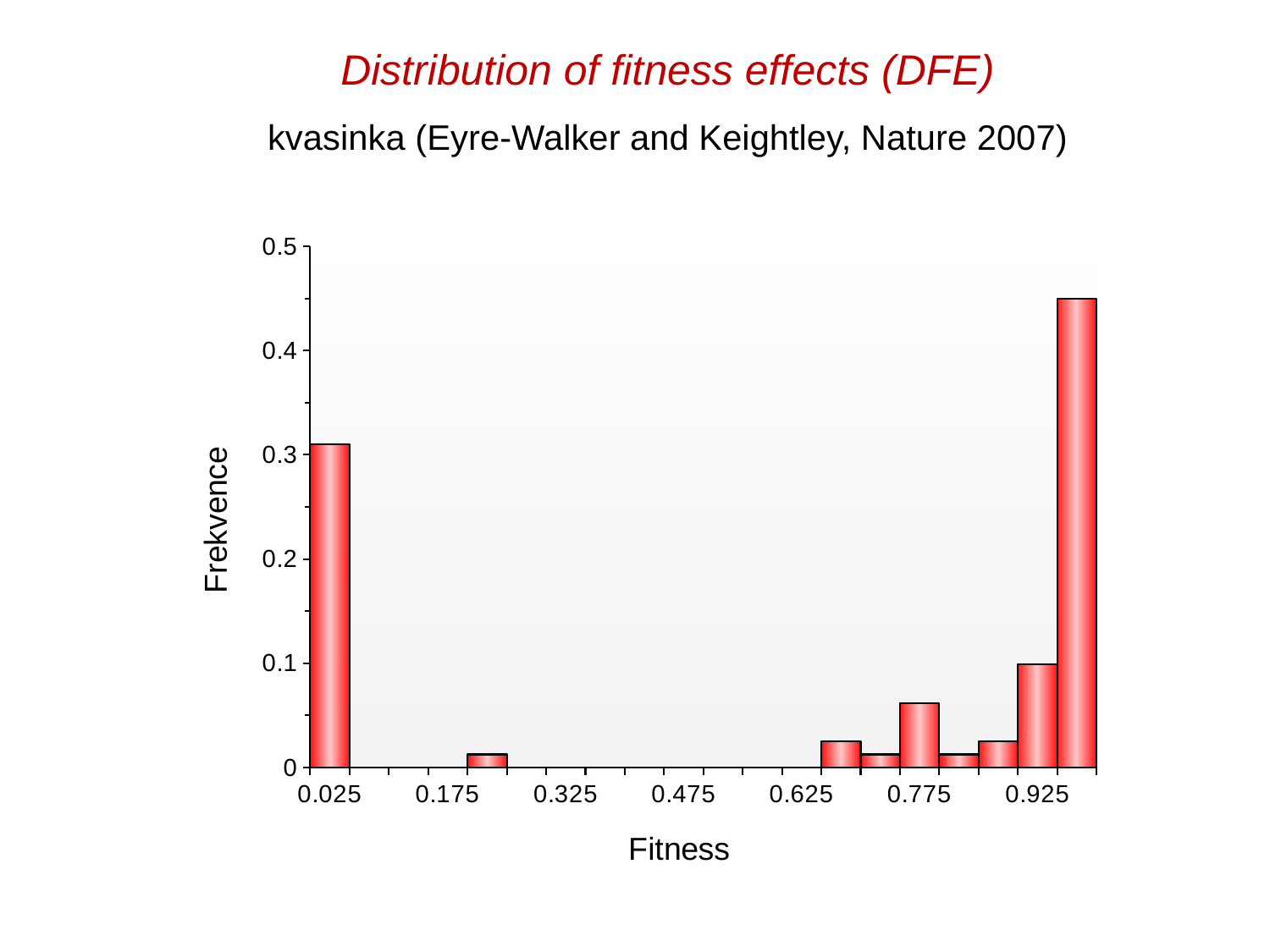
How many tick labels are shown on the Fitness axis? 7 What is the title of the chart on the slide? Distribution of fitness effects (DFE) Is the tallest bar at the left end or the right end of the x axis? right end Is the value for Fitness 0.775 greater or less than 0.1? less Is the value of the tallest bar greater or less than 0.4? greater What kind of chart is shown on the slide? bar chart What is the label of the y axis? Frekvence Which has the larger value, the bar at Fitness 0.025 or the bar at Fitness 0.775? 0.025 Is the value for Fitness 0.025 greater or less than 0.4? less How many bars are plotted in the chart? 9